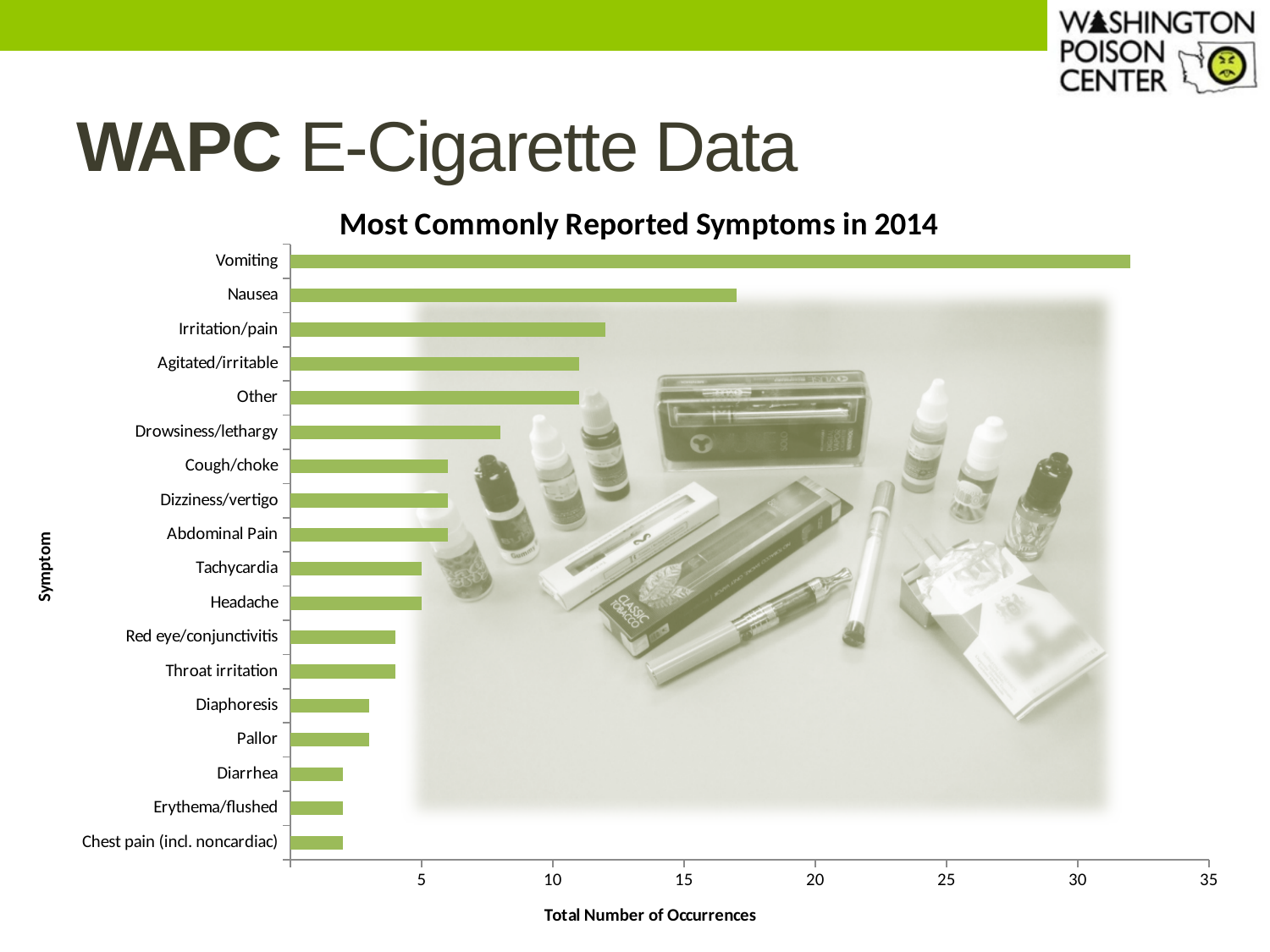
Which has more occurrences, Nausea or Irritation/pain? Nausea Is the value for Irritation/pain greater or less than 15? less Which symptom has the highest number of occurrences? Vomiting Is the value for Nausea greater or less than 15? greater Is the value for Diarrhea greater or less than 5? less Which has more occurrences, Drowsiness/lethargy or Cough/choke? Drowsiness/lethargy What kind of chart is shown on the slide? bar chart How many symptoms are listed on the chart? 18 What is the title of the chart? Most Commonly Reported Symptoms in 2014 What is the label of the horizontal axis? Total Number of Occurrences